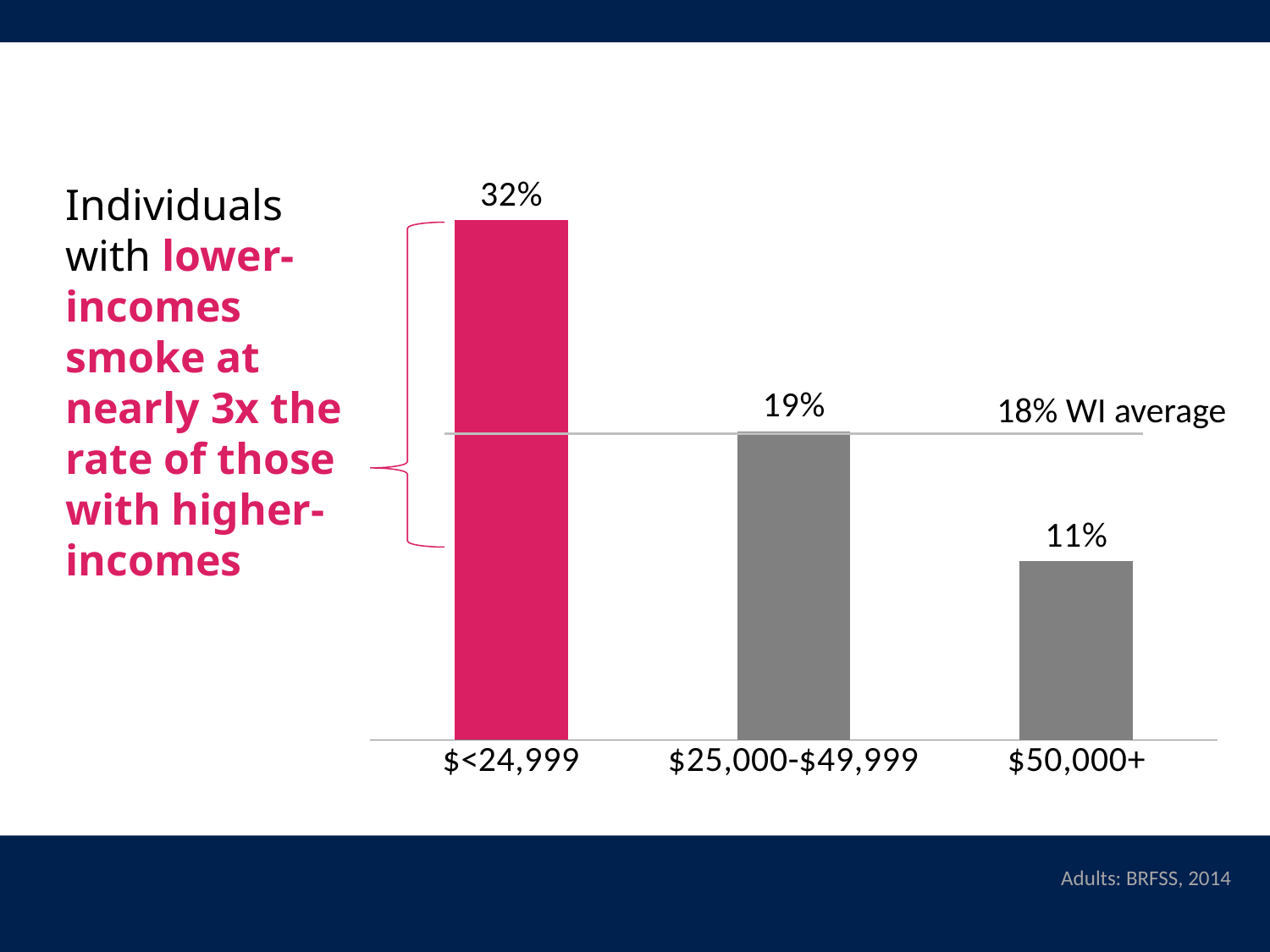
Which income group has the lowest smoking rate? $50,000+ What is the smoking rate for the $<24,999 income group? 32% How many income categories are shown in the chart? 3 Do the smoking rates rise or fall as income increases along the x axis? Fall What value does the horizontal reference line labelled 'WI average' represent? 18% Which income group has the highest smoking rate? $<24,999 What is the smoking rate for the $50,000+ income group? 11% What is the difference in smoking rate between the $25,000-$49,999 group and the $50,000+ group? 8% What kind of chart is shown on the slide? Bar chart Which group has a higher smoking rate, $25,000-$49,999 or $50,000+? $25,000-$49,999 What is the difference in smoking rate between the $<24,999 group and the $50,000+ group? 21% What is the smoking rate for the $25,000-$49,999 income group? 19%